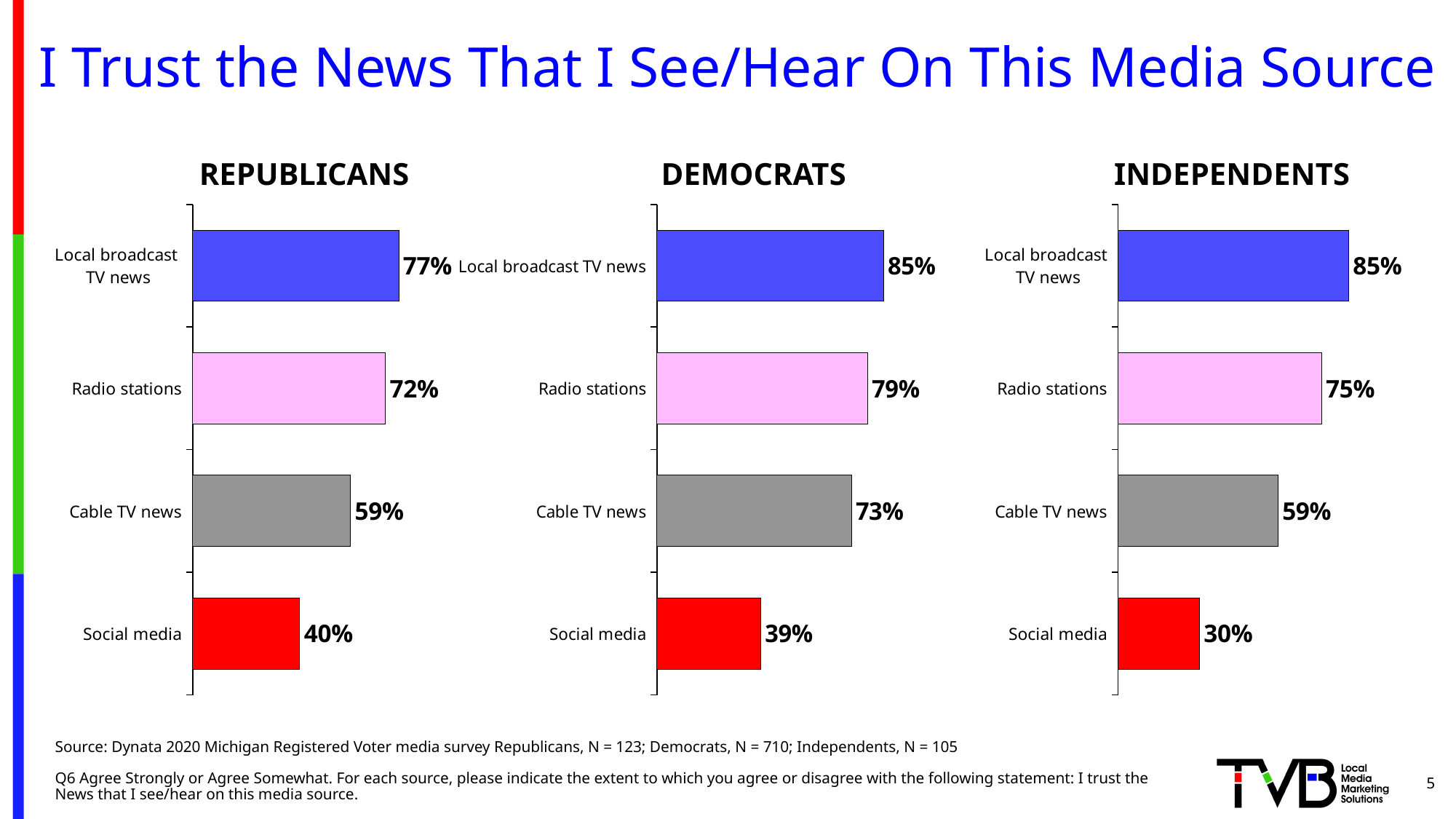
What kind of chart is the REPUBLICANS chart? Bar chart How many media sources are shown in the INDEPENDENTS chart? 4 In the REPUBLICANS chart, do the values rise or fall from Local broadcast TV news down to Social media? Fall Which is larger: Cable TV news in the REPUBLICANS chart or Cable TV news in the DEMOCRATS chart? DEMOCRATS In the DEMOCRATS chart, what is the value for Cable TV news? 73% In the REPUBLICANS chart, what is the value for Local broadcast TV news? 77% In the INDEPENDENTS chart, what is the value for Social media? 30% In the DEMOCRATS chart, what is the difference between Radio stations and Social media? 40% In the INDEPENDENTS chart, what is the difference between Local broadcast TV news and Radio stations? 10% In the INDEPENDENTS chart, what colour is the Social media bar? Red In the DEMOCRATS chart, which media source has the highest value? Local broadcast TV news In the REPUBLICANS chart, which media source has the lowest value? Social media